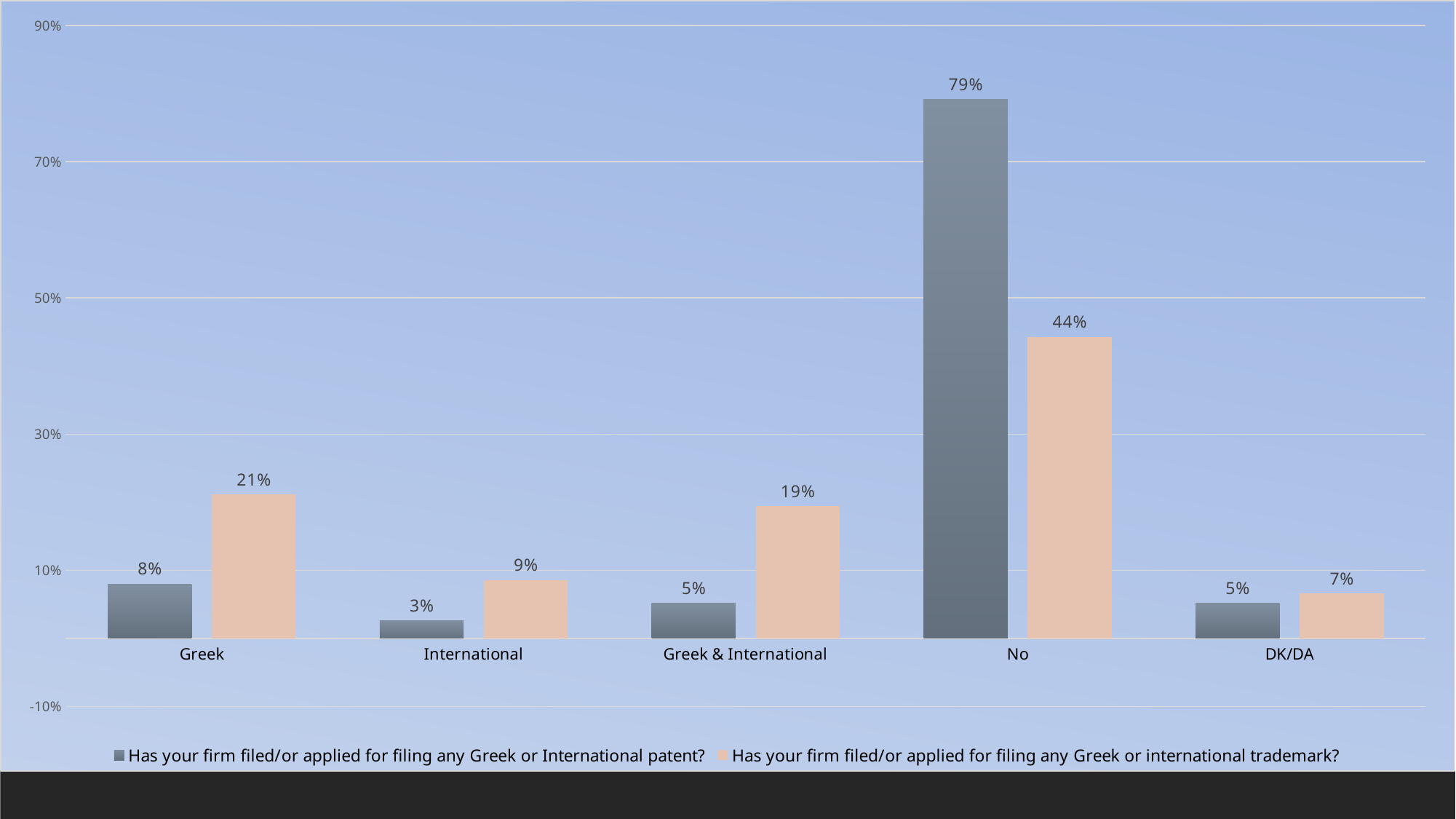
How many series does the legend list? 2 What is the value for "Greek & International" in the trademark series? 19% Which category has the lowest value in the patent series? International What kind of chart is shown on the slide? bar chart How many categories are shown on the x axis? 5 What is the value for "Greek" in the trademark series? 21% What is the value for "International" in the patent series? 3% Which is larger for "DK/DA": the patent value or the trademark value? the trademark value What is the value for "No" in the patent series? 79% What is the difference between the patent and trademark values for "No"? 35% Which category has the highest value in the trademark series? No What colour are the bars for the trademark series? peach/light orange